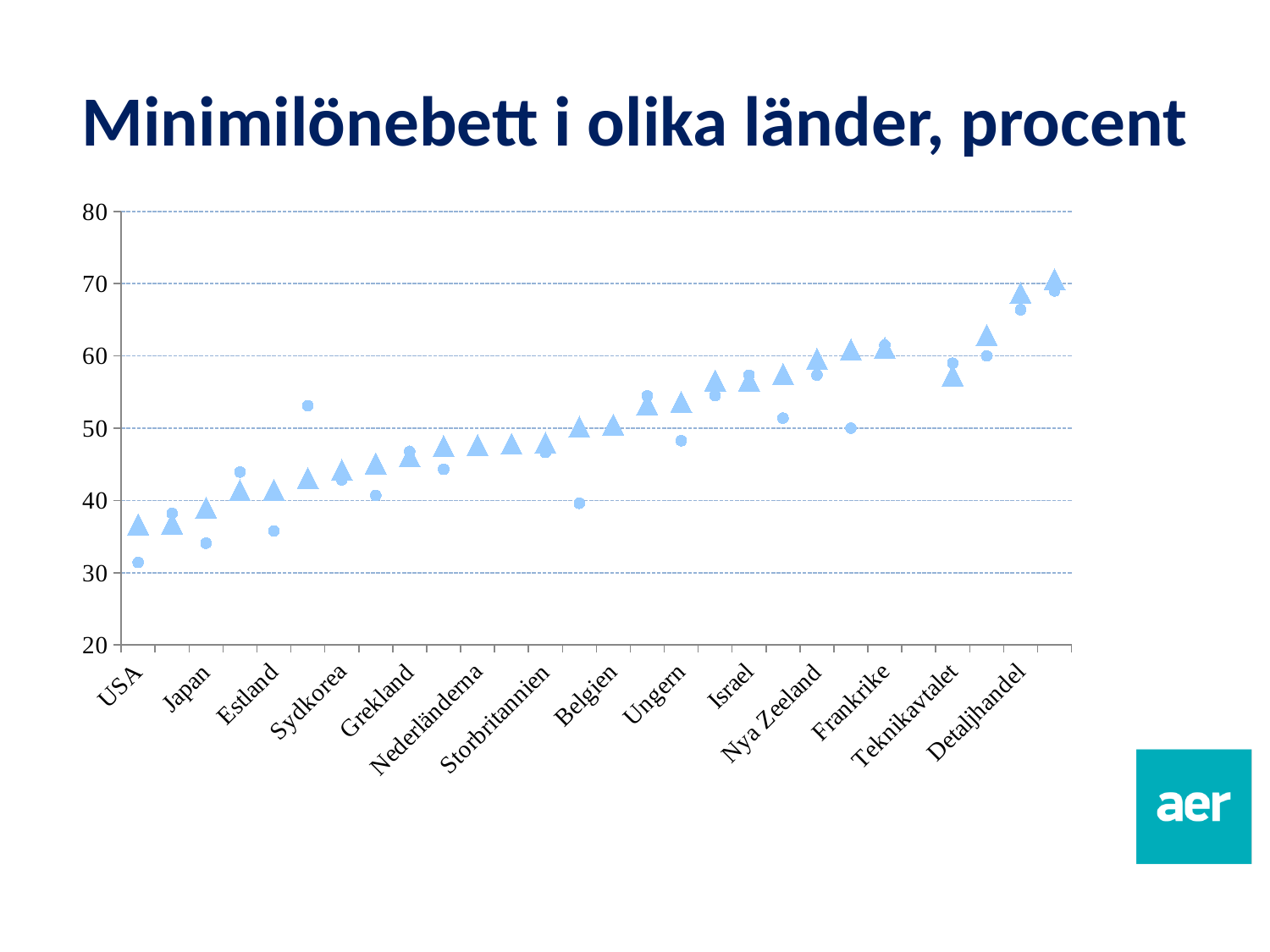
Is the circle-marker value for Israel greater or less than 50? greater Do the plotted values generally rise or fall from left to right along the x axis? rise How many category labels are shown on the x axis? 14 Is the triangle-marker value for Teknikavtalet greater or less than 60? less What is the title of the chart? Minimilönebett i olika länder, procent Is the triangle-marker value for Sydkorea greater or less than 50? less What kind of chart is shown on the slide? scatter chart Which labelled category has the lowest plotted values? USA Which labelled category has the highest plotted values? Detaljhandel